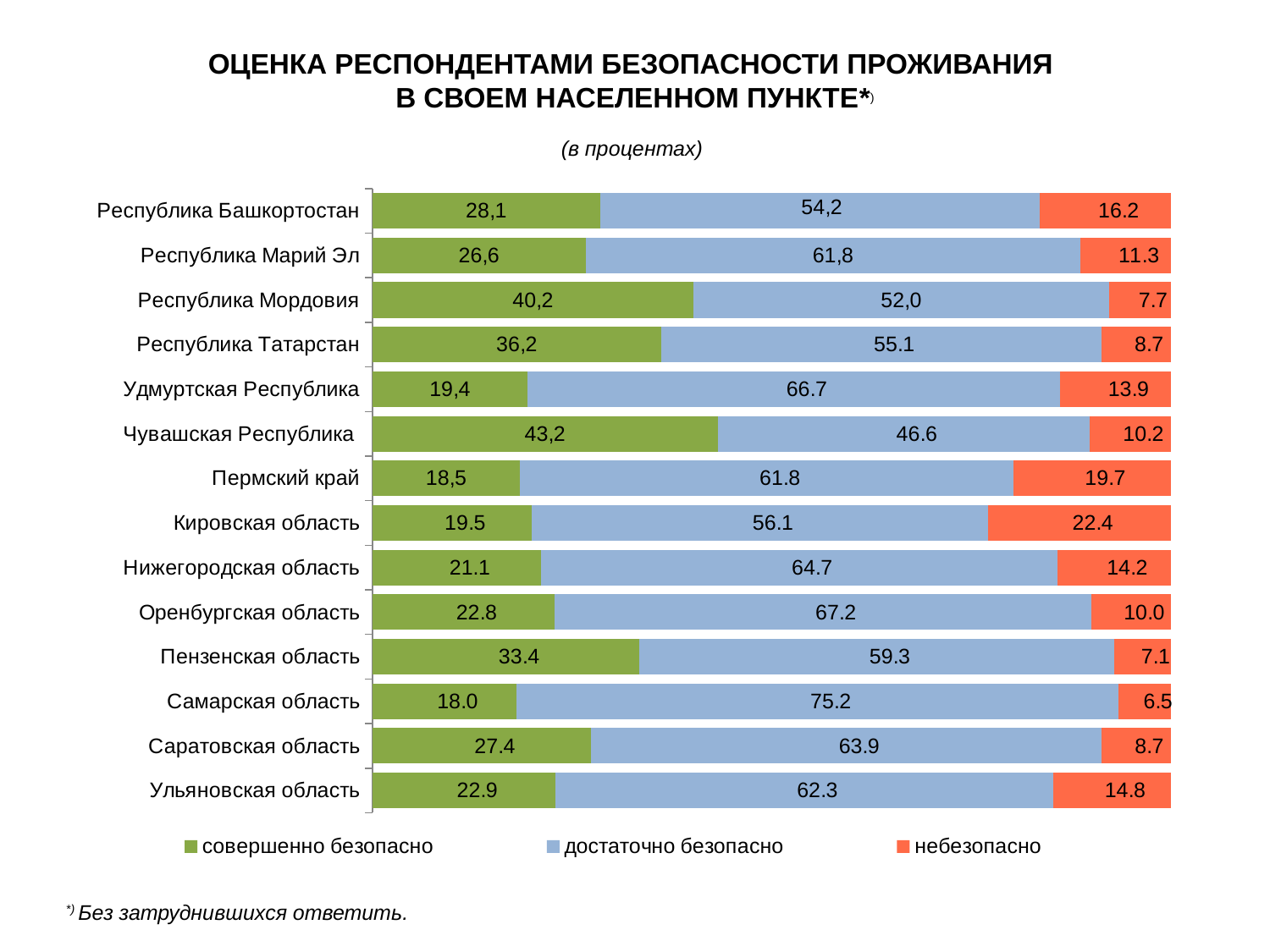
What kind of chart is shown on the slide? Stacked bar chart What is the value for "совершенно безопасно" for Республика Башкортостан? 28,1 What is the value for "достаточно безопасно" for Самарская область? 75.2 Which has the larger "совершенно безопасно" value, Республика Мордовия or Республика Татарстан? Республика Мордовия Which region has the lowest value for "небезопасно"? Самарская область Which region has the highest value for "небезопасно"? Кировская область Which region has the highest value for "совершенно безопасно"? Чувашская Республика How many series does the legend list? 3 Which region has the lowest value for "совершенно безопасно"? Самарская область What is the value for "небезопасно" for Пермский край? 19.7 What is the difference between the "небезопасно" values for Кировская область and Самарская область? 15.9 How many regions are shown in the chart? 14